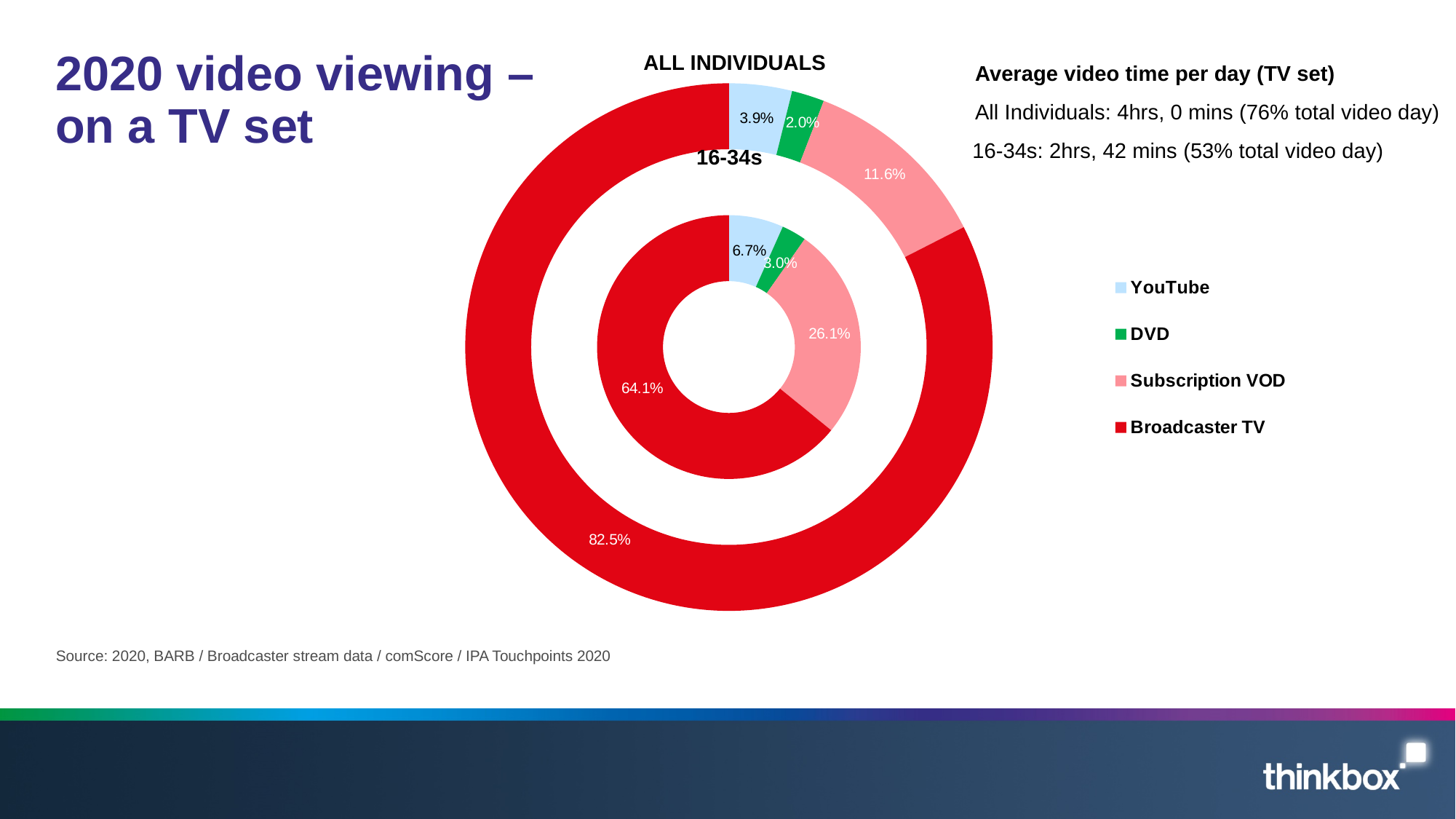
What is the difference between the Broadcaster TV share for All Individuals and for 16-34s? 18.4 percentage points What is the YouTube share for All Individuals in the doughnut chart? 3.9% What is the DVD share for 16-34s in the doughnut chart? 3.0% Which category has the largest share in the 16-34s ring? Broadcaster TV How many series does the legend list? 4 What kind of chart is shown on the slide? Doughnut chart Which is larger: the Subscription VOD share for 16-34s or for All Individuals? 16-34s Which category has the smallest share in the All Individuals ring? DVD Which colour represents Subscription VOD in the chart? Pink Which audience group does the inner ring of the doughnut chart represent? 16-34s What share of video viewing on a TV set does Broadcaster TV account for among All Individuals? 82.5% What share of video viewing on a TV set does Subscription VOD account for among 16-34s? 26.1%